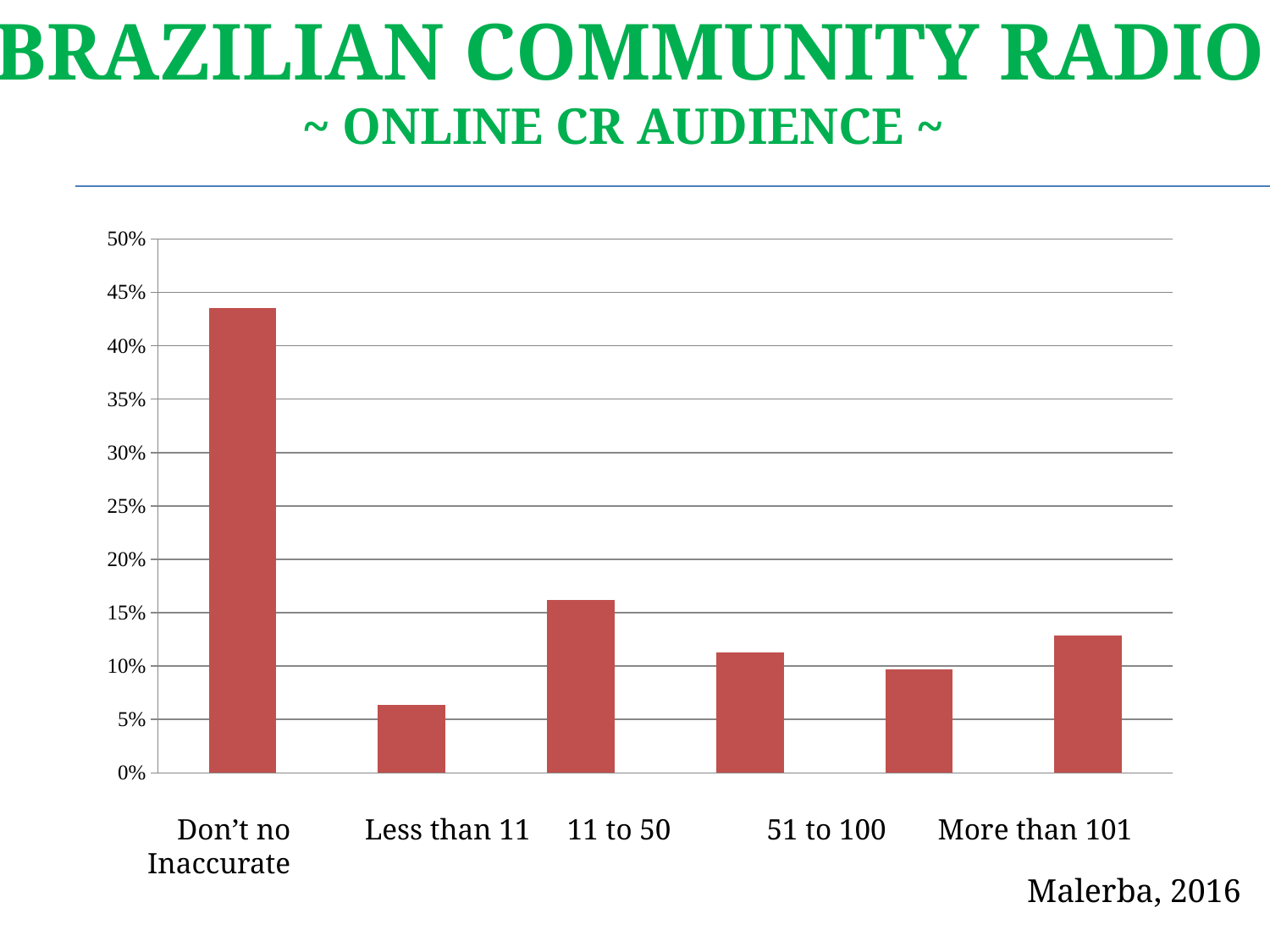
What is the highest value shown on the vertical axis? 50% What kind of chart is shown on the slide? bar chart Is the value of the fourth bar greater or less than 10%? greater Is the value of the second bar greater or less than 10%? less Which bar is the shortest in the chart? the second bar Which is larger, the value of the third bar or the value of the second bar? the third bar Is the value of the first bar (Don't no Inaccurate) greater or less than 40%? greater Which bar is the tallest in the chart? the first bar (Don't no Inaccurate) What colour are the bars in the chart? red How many bars are plotted in the chart? 6